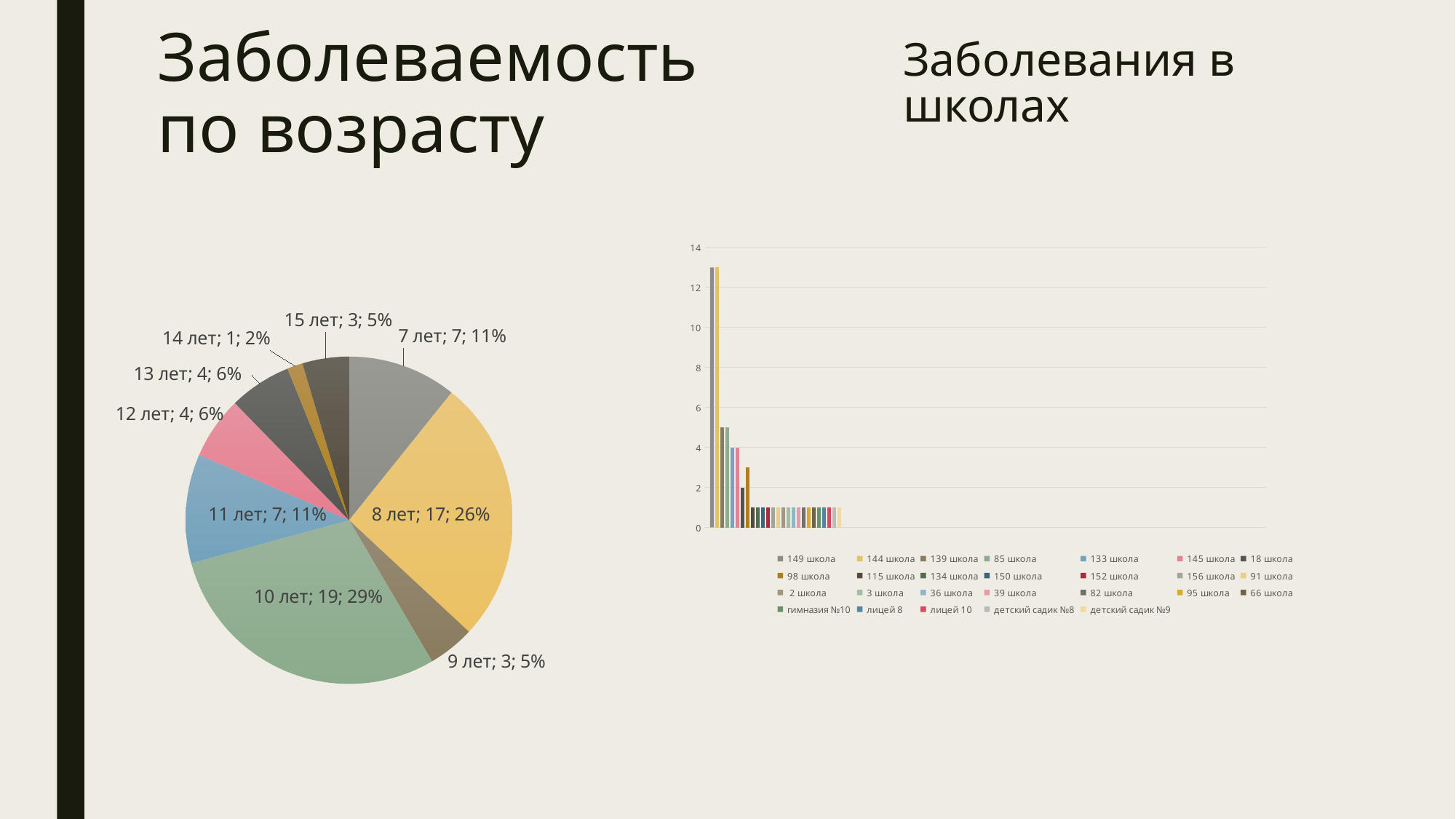
On the pie chart 'Заболеваемость по возрасту', what is the value for 10 лет? 19 On the pie chart 'Заболеваемость по возрасту', which is larger: the value for 7 лет or the value for 12 лет? 7 лет On the pie chart 'Заболеваемость по возрасту', what is the value for 15 лет? 3 On the pie chart 'Заболеваемость по возрасту', which age group has the smallest slice? 14 лет On the chart 'Заболевания в школах', how many series does the legend list? 26 What kind of chart is 'Заболевания в школах'? Bar chart On the pie chart 'Заболеваемость по возрасту', what percentage share does 8 лет have? 26% On the pie chart 'Заболеваемость по возрасту', what is the difference between the values for 10 лет and 8 лет? 2 On the pie chart 'Заболеваемость по возрасту', how many age groups are shown? 9 What kind of chart is 'Заболеваемость по возрасту'? Pie chart On the chart 'Заболевания в школах', is the value for 149 школа greater or less than 12? greater On the pie chart 'Заболеваемость по возрасту', which age group has the largest slice? 10 лет